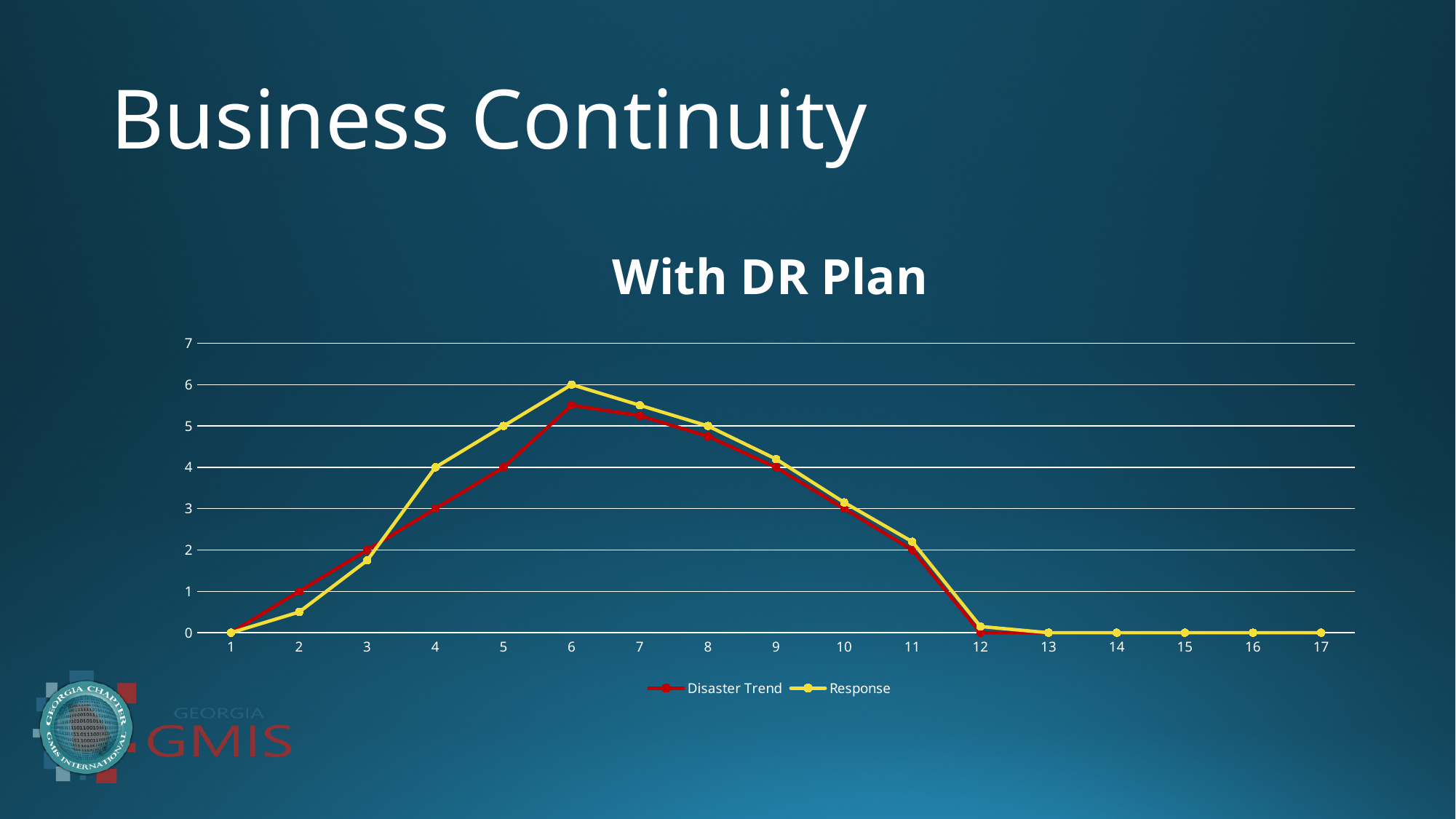
How many points are plotted along the x axis for each series? 17 At which x value does the Response series reach its highest point? 6 At x = 4, which series has the larger value, Disaster Trend or Response? Response Do the values of the Disaster Trend series rise or fall between x = 6 and x = 12? fall What is the value of the Disaster Trend series at x = 5? 4 How many series does the legend list? 2 Is the value of the Disaster Trend series at x = 6 greater or less than 5? greater What is the title of the chart? With DR Plan What is the value of the Response series at x = 8? 5 Is the value of the Response series at x = 2 greater or less than 1? less What kind of chart is shown on the slide? line chart What is the value of the Response series at x = 6? 6